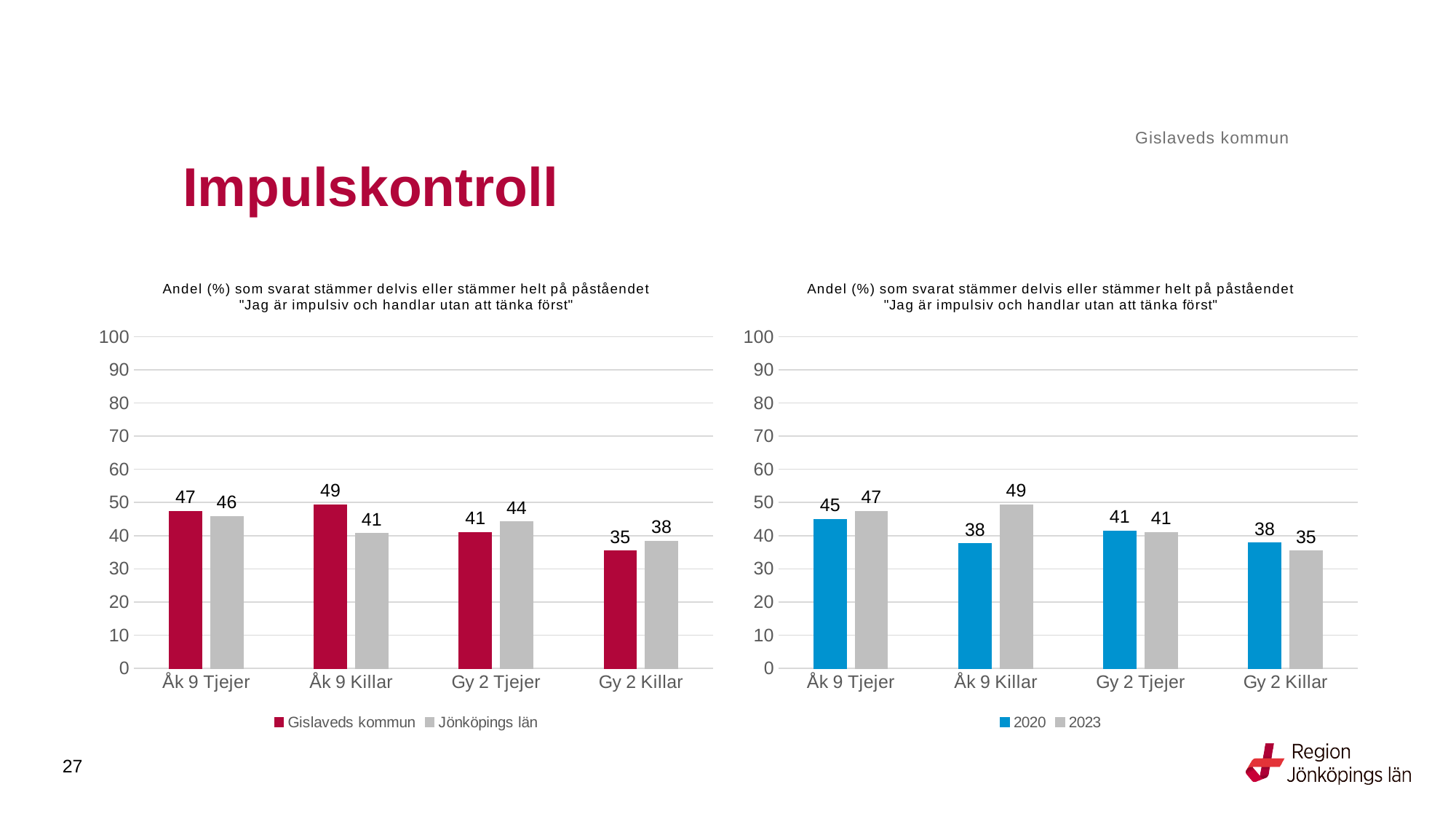
In the right chart, which category has the highest value for 2023? Åk 9 Killar In the left chart, which is larger for Gy 2 Tjejer: Gislaveds kommun or Jönköpings län? Jönköpings län In the left chart, what is the difference between Gislaveds kommun and Jönköpings län for Åk 9 Killar? 8 In the left chart, which category has the lowest value for Gislaveds kommun? Gy 2 Killar In the right chart, what is the value for 2020 for Gy 2 Killar? 38 In the right chart, what is the difference between 2023 and 2020 for Åk 9 Killar? 11 In the right chart, what is the value for 2023 for Åk 9 Killar? 49 In the right chart, how many categories are shown on the x axis? 4 How many series does the legend of the right chart list? 2 What kind of chart is the left chart? Bar chart In the left chart, what is the value for Jönköpings län for Gy 2 Tjejer? 44 In the left chart, what is the value for Gislaveds kommun for Åk 9 Killar? 49